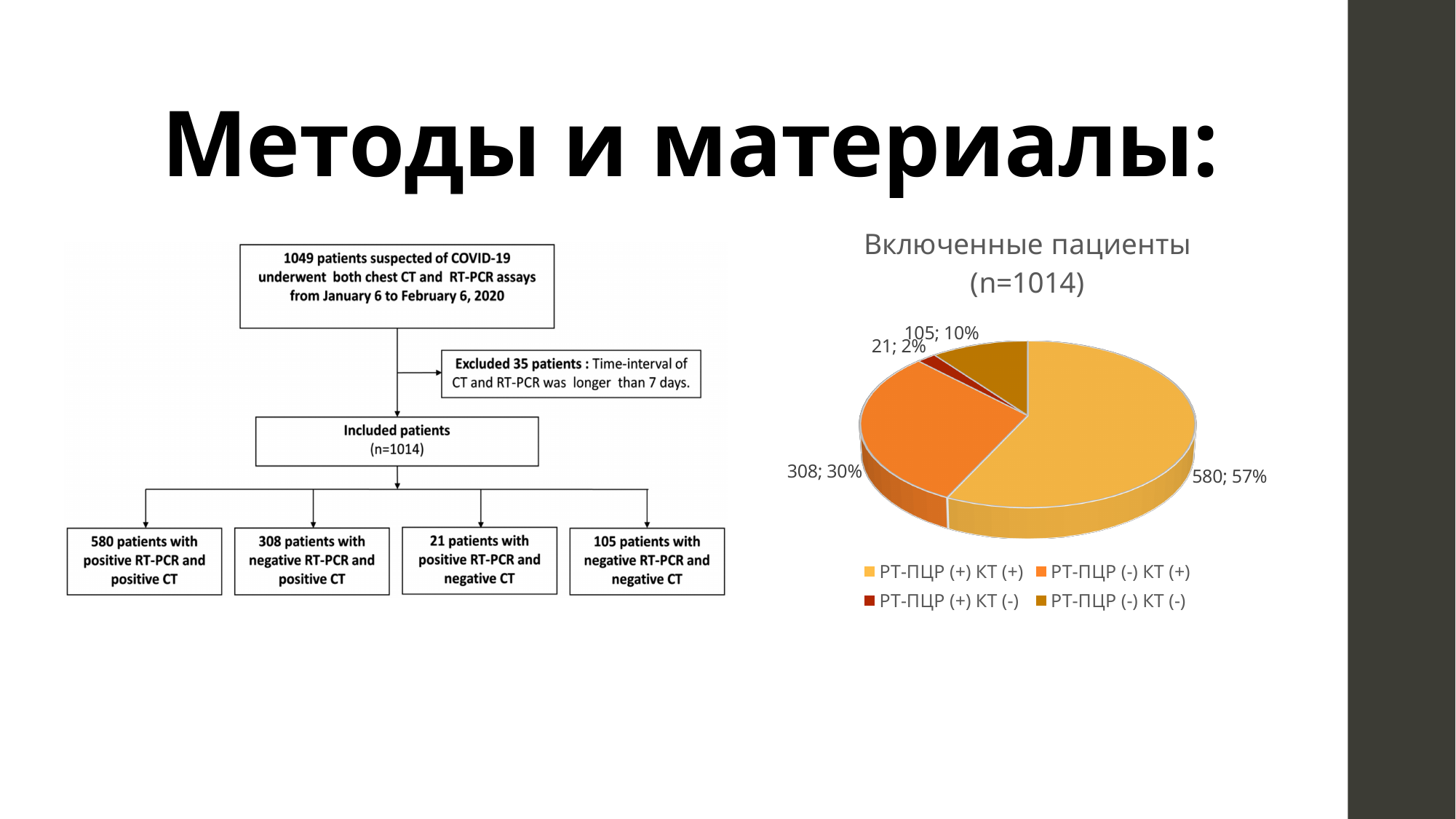
In the pie chart, what share of patients does the РТ-ПЦР (-) КТ (-) slice represent? 10% Which category in the pie chart has the largest number of patients? РТ-ПЦР (+) КТ (+) In the pie chart, which has more patients: РТ-ПЦР (-) КТ (-) or РТ-ПЦР (+) КТ (-)? РТ-ПЦР (-) КТ (-) In the pie chart, how many patients are in the РТ-ПЦР (+) КТ (-) category? 21 How many categories does the legend of the pie chart list? 4 In the pie chart, what share of patients does the РТ-ПЦР (-) КТ (+) slice represent? 30% What type of chart is shown under the title "Включенные пациенты (n=1014)"? Pie chart In the pie chart, how many patients are in the РТ-ПЦР (-) КТ (+) category? 308 Which category in the pie chart has the smallest number of patients? РТ-ПЦР (+) КТ (-) In the pie chart, how many patients are in the РТ-ПЦР (-) КТ (-) category? 105 In the pie chart, how many patients are in the РТ-ПЦР (+) КТ (+) category? 580 In the pie chart, what is the difference in patient count between РТ-ПЦР (+) КТ (+) and РТ-ПЦР (-) КТ (+)? 272